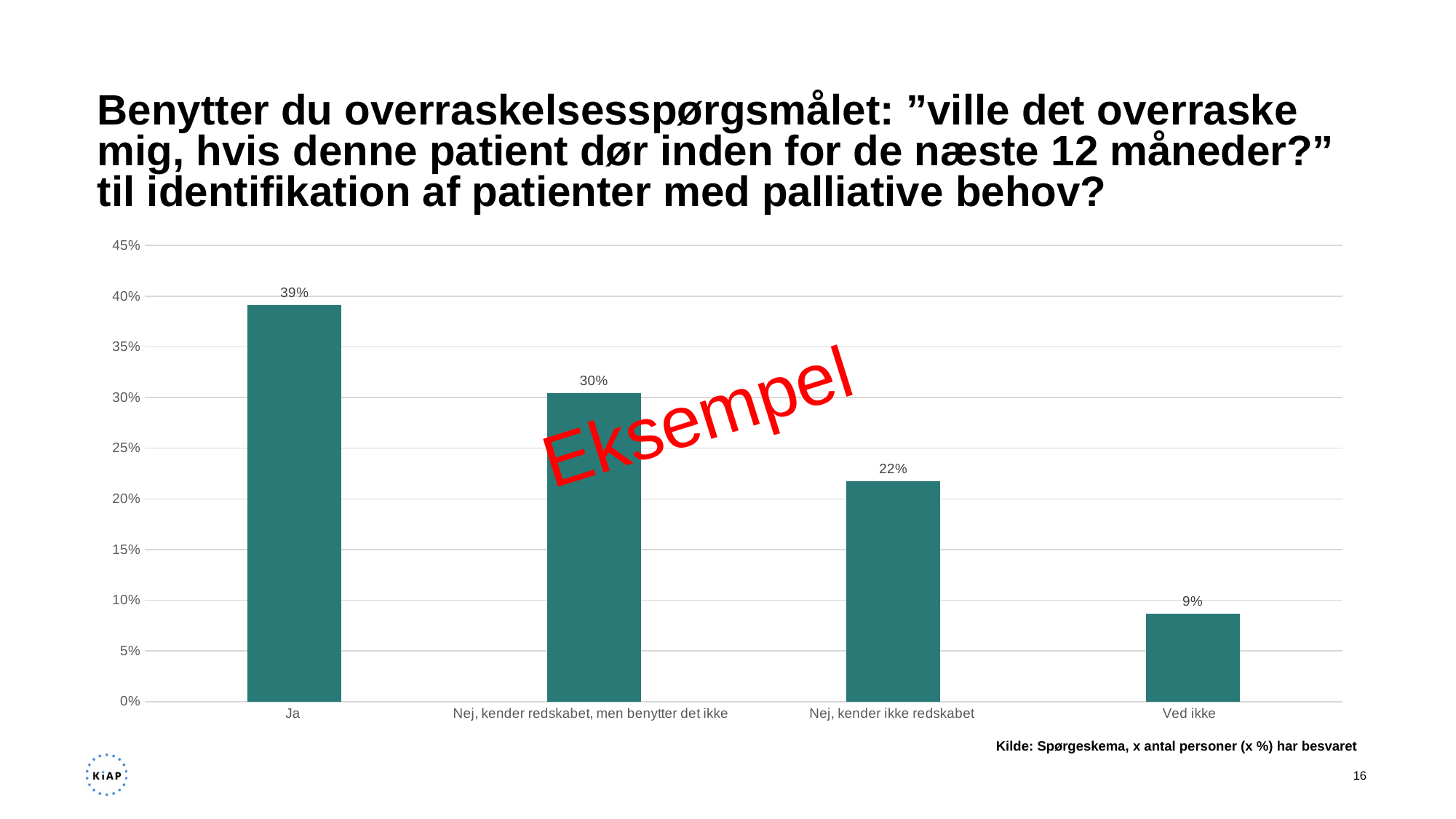
Is the value for "Nej, kender ikke redskabet" greater or less than 25%? less What kind of chart is shown on the slide? Bar chart Which category has the lowest value? Ved ikke What is the value for "Ja"? 39% What red word is stamped diagonally across the chart? Eksempel What is the value for "Nej, kender redskabet, men benytter det ikke"? 30% How many categories are shown on the x axis? 4 Which category has the highest value? Ja What is the value for "Nej, kender ikke redskabet"? 22% What is the difference between the values for "Ja" and "Nej, kender ikke redskabet"? 17% What is the value for "Ved ikke"? 9% Which is larger: the value for "Nej, kender redskabet, men benytter det ikke" or the value for "Ved ikke"? Nej, kender redskabet, men benytter det ikke